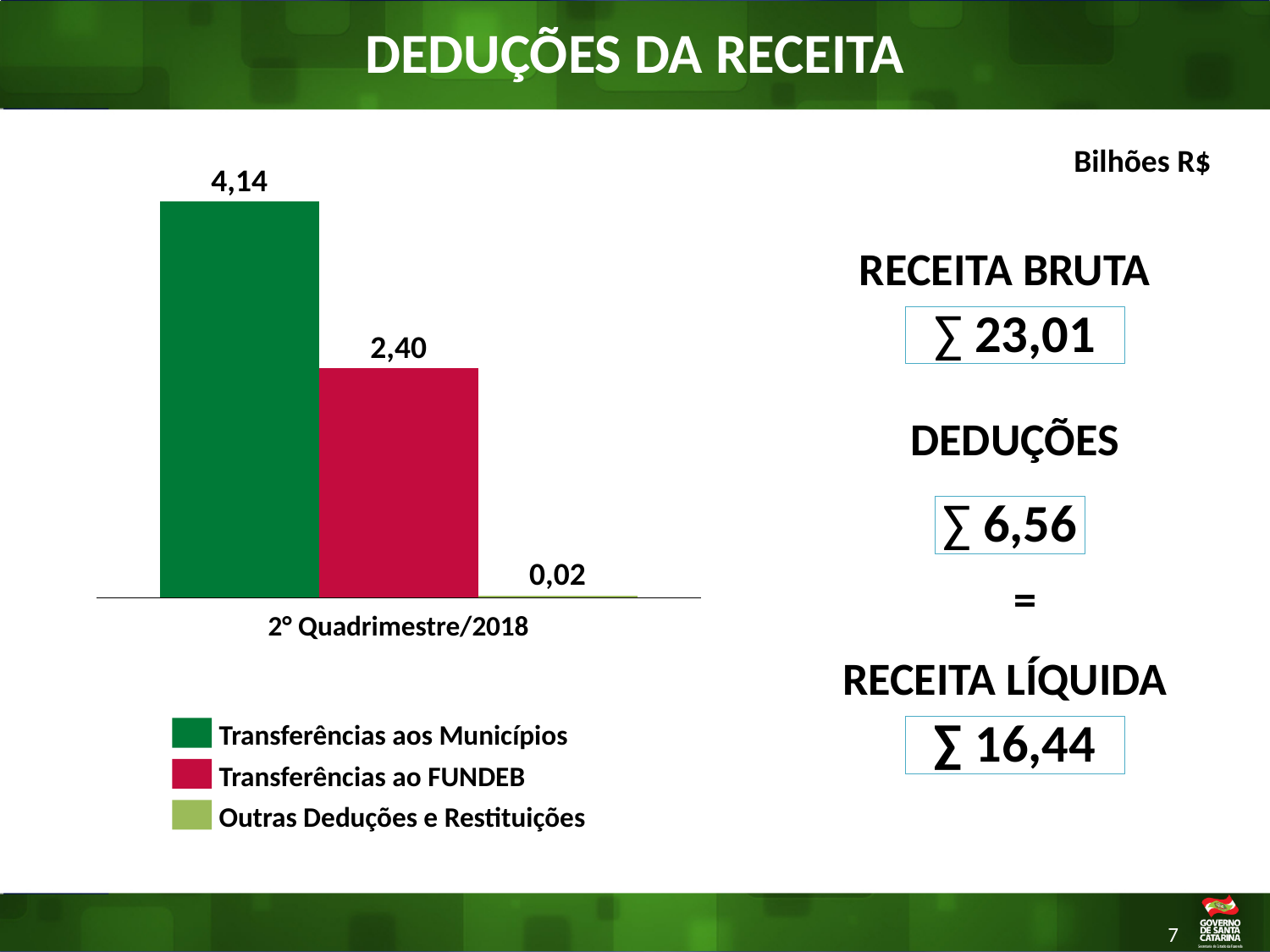
What is the value for Outras Deduções e Restituições? 0,02 What kind of chart is shown on the slide? Bar chart What is the category label shown on the x axis? 2° Quadrimestre/2018 What is the value for Transferências ao FUNDEB? 2,40 Which series has the lowest value? Outras Deduções e Restituições What is the total of the three plotted values? 6,56 Which is larger, Transferências ao FUNDEB or Outras Deduções e Restituições? Transferências ao FUNDEB Which series has the highest value? Transferências aos Municípios What colour is the bar for Transferências ao FUNDEB? Red What is the difference between Transferências aos Municípios and Transferências ao FUNDEB? 1,74 How many series does the legend list? 3 What is the value for Transferências aos Municípios? 4,14